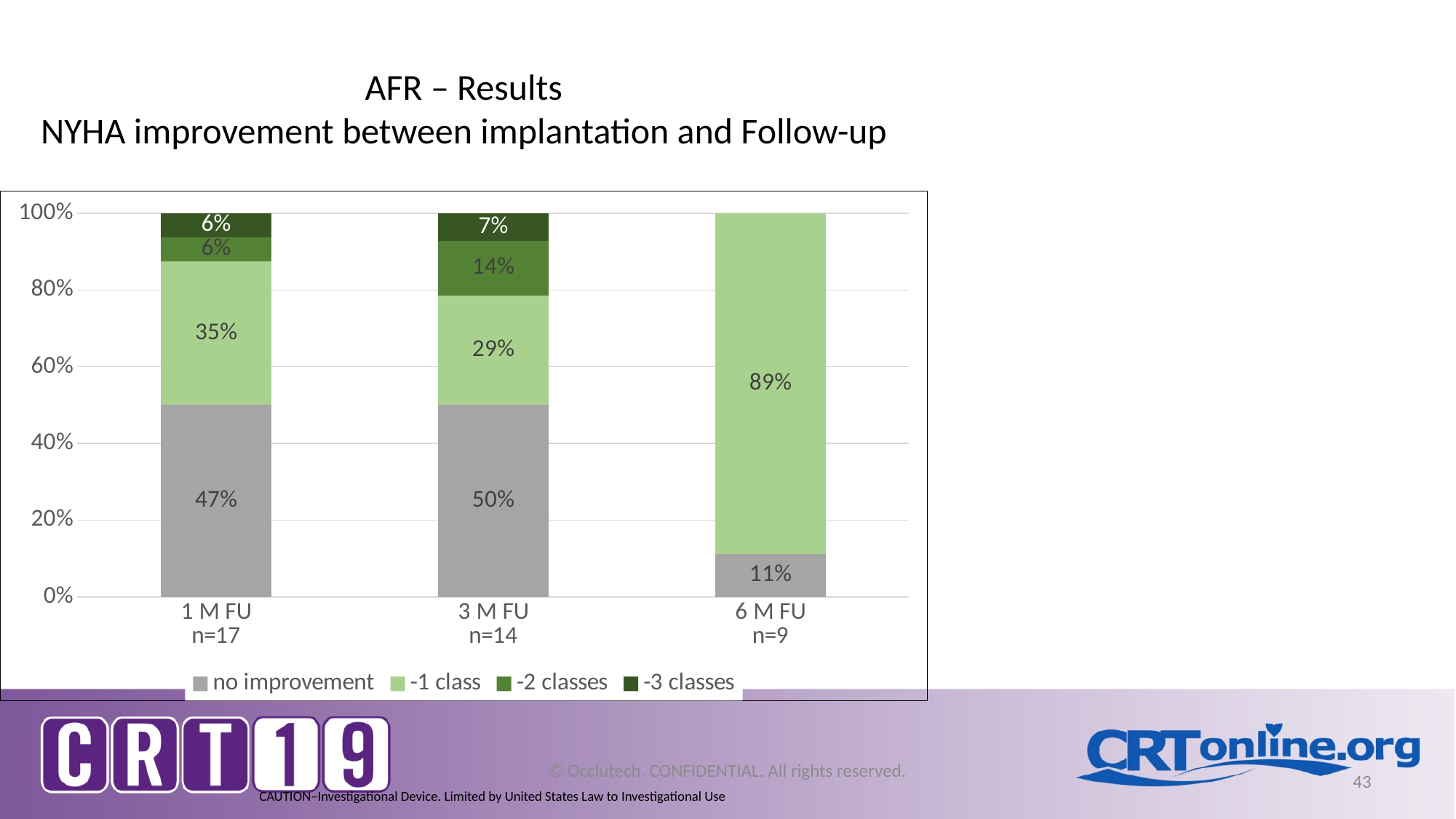
Which follow-up category has the highest '-1 class' value? 6 M FU What is the 'no improvement' value for 3 M FU? 50% Which follow-up category has the lowest 'no improvement' value? 6 M FU What kind of chart is shown on the slide? stacked bar chart How many follow-up categories are shown on the x axis? 3 How many series does the legend list? 4 What is the '-2 classes' value for 3 M FU? 14% What is the '-1 class' value for 6 M FU? 89% Is the '-2 classes' value larger for 1 M FU or 3 M FU? 3 M FU What is the sample size (n) shown for the 3 M FU category? n=14 What is the difference between the '-1 class' values for 1 M FU and 3 M FU? 6% What is the '-3 classes' value for 1 M FU? 6%